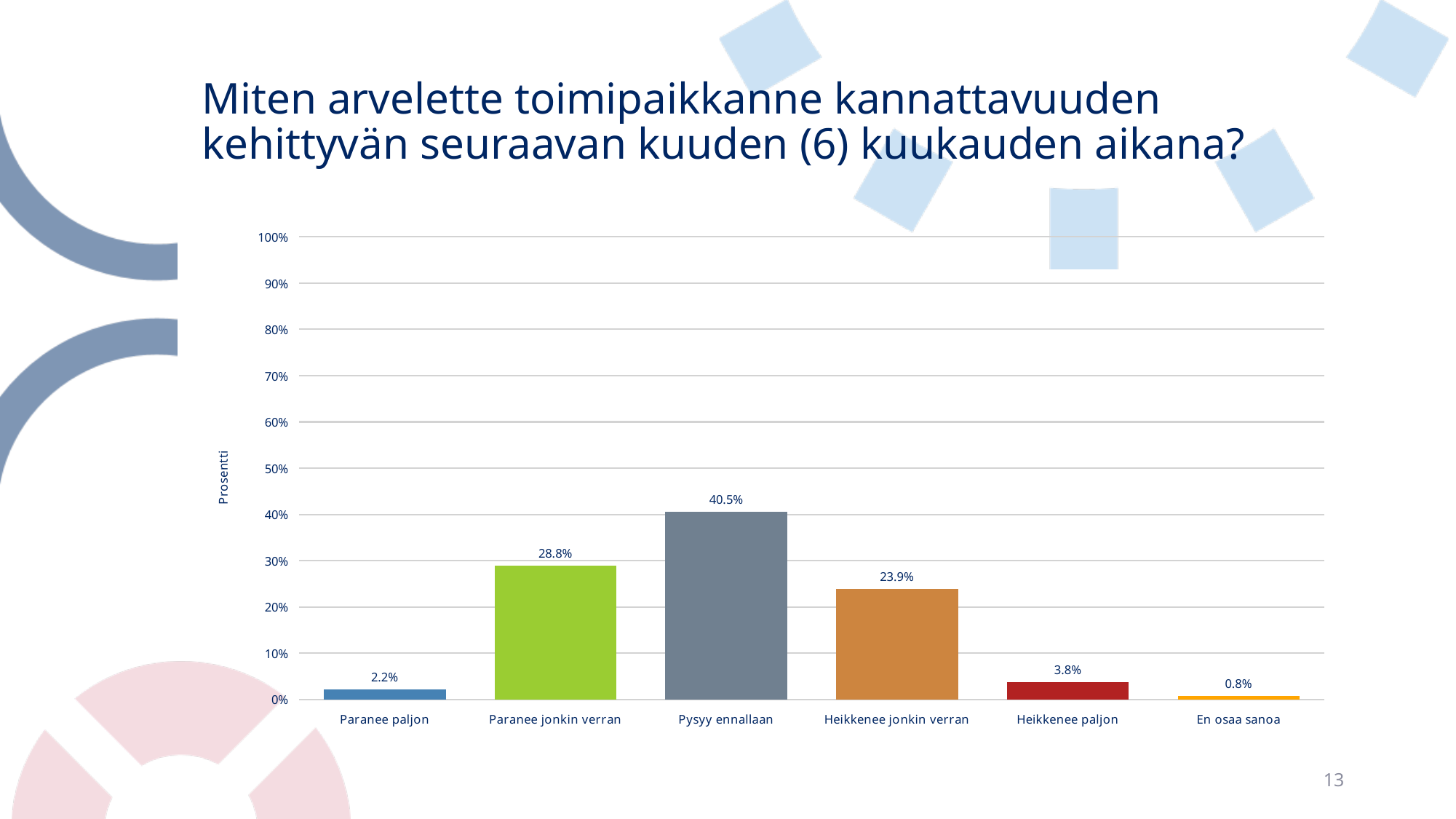
What is the label of the vertical axis? Prosentti Is the value for "Heikkenee jonkin verran" greater or less than 30%? less Which category has the lowest value? En osaa sanoa What is the difference between "Pysyy ennallaan" and "Heikkenee jonkin verran"? 16.6% What is the value for "Paranee jonkin verran"? 28.8% What kind of chart is shown on the slide? bar chart How many categories are shown on the x axis? 6 Which is larger, "Paranee paljon" or "Heikkenee paljon"? Heikkenee paljon What is the value for "Heikkenee paljon"? 3.8% What is the value for "En osaa sanoa"? 0.8% Which category has the highest value? Pysyy ennallaan What is the value for "Pysyy ennallaan"? 40.5%